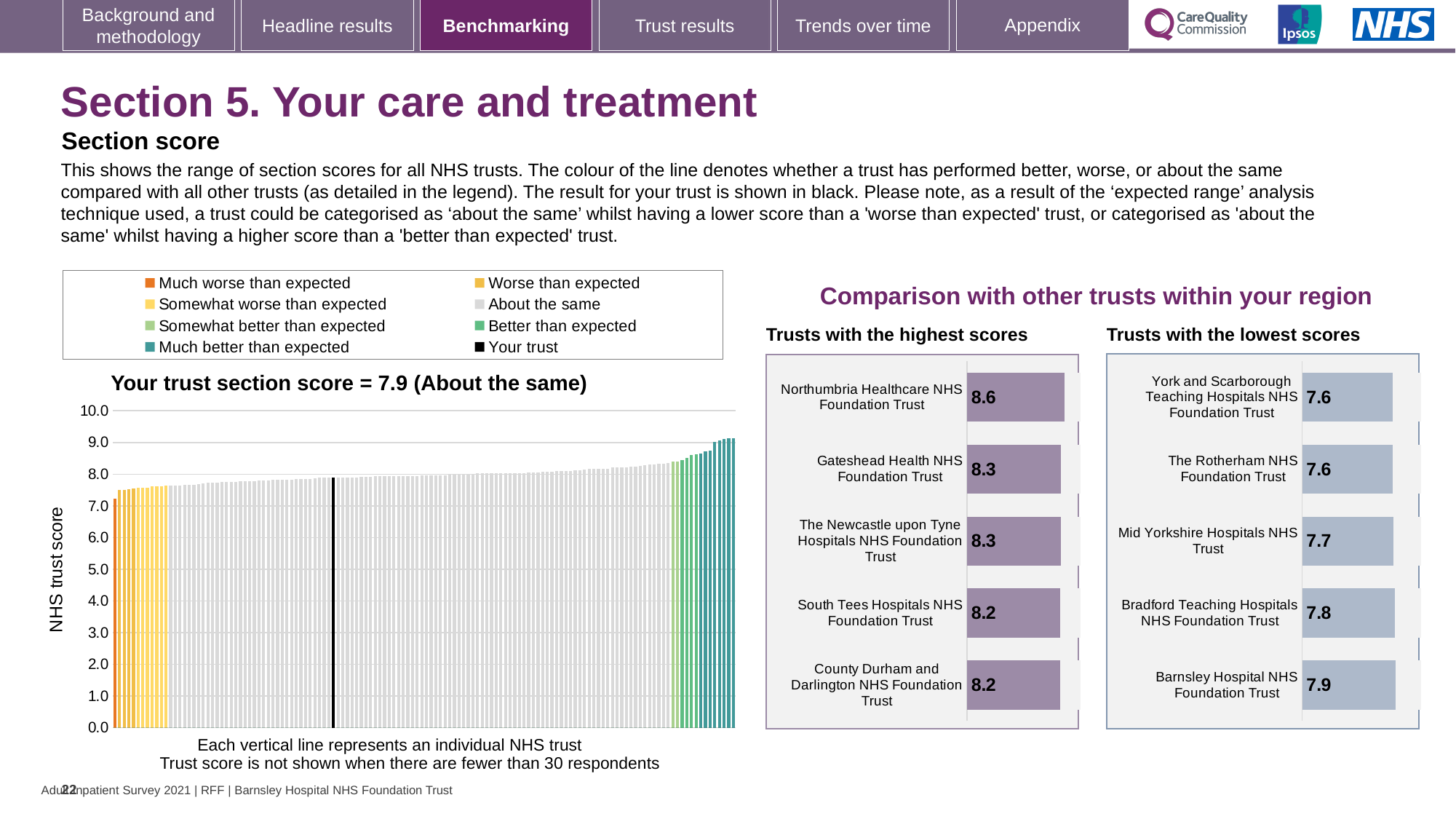
On the 'Trusts with the highest scores' chart, what is the score for Northumbria Healthcare NHS Foundation Trust? 8.6 On the 'Trusts with the lowest scores' chart, how many trusts are shown? 5 On the 'Trusts with the lowest scores' chart, what is the score for Mid Yorkshire Hospitals NHS Trust? 7.7 On the 'Your trust section score' chart, what is the section score for your trust? 7.9 On the 'Your trust section score' chart, what category does your trust fall into according to the chart title? About the same On the 'Your trust section score' chart, is the value of the leftmost (orange) bar greater or less than 7.0? greater On the 'Your trust section score' chart, how many entries does the legend list? 8 What kind of chart is the 'Your trust section score' chart? Bar chart On the 'Trusts with the highest scores' chart, what is the difference between the scores of Northumbria Healthcare NHS Foundation Trust and South Tees Hospitals NHS Foundation Trust? 0.4 On the 'Your trust section score' chart, do the trust scores rise or fall from left to right? Rise On the 'Trusts with the highest scores' chart, which trust has the highest score? Northumbria Healthcare NHS Foundation Trust On the 'Trusts with the lowest scores' chart, which has the larger score, Bradford Teaching Hospitals NHS Foundation Trust or Mid Yorkshire Hospitals NHS Trust? Bradford Teaching Hospitals NHS Foundation Trust